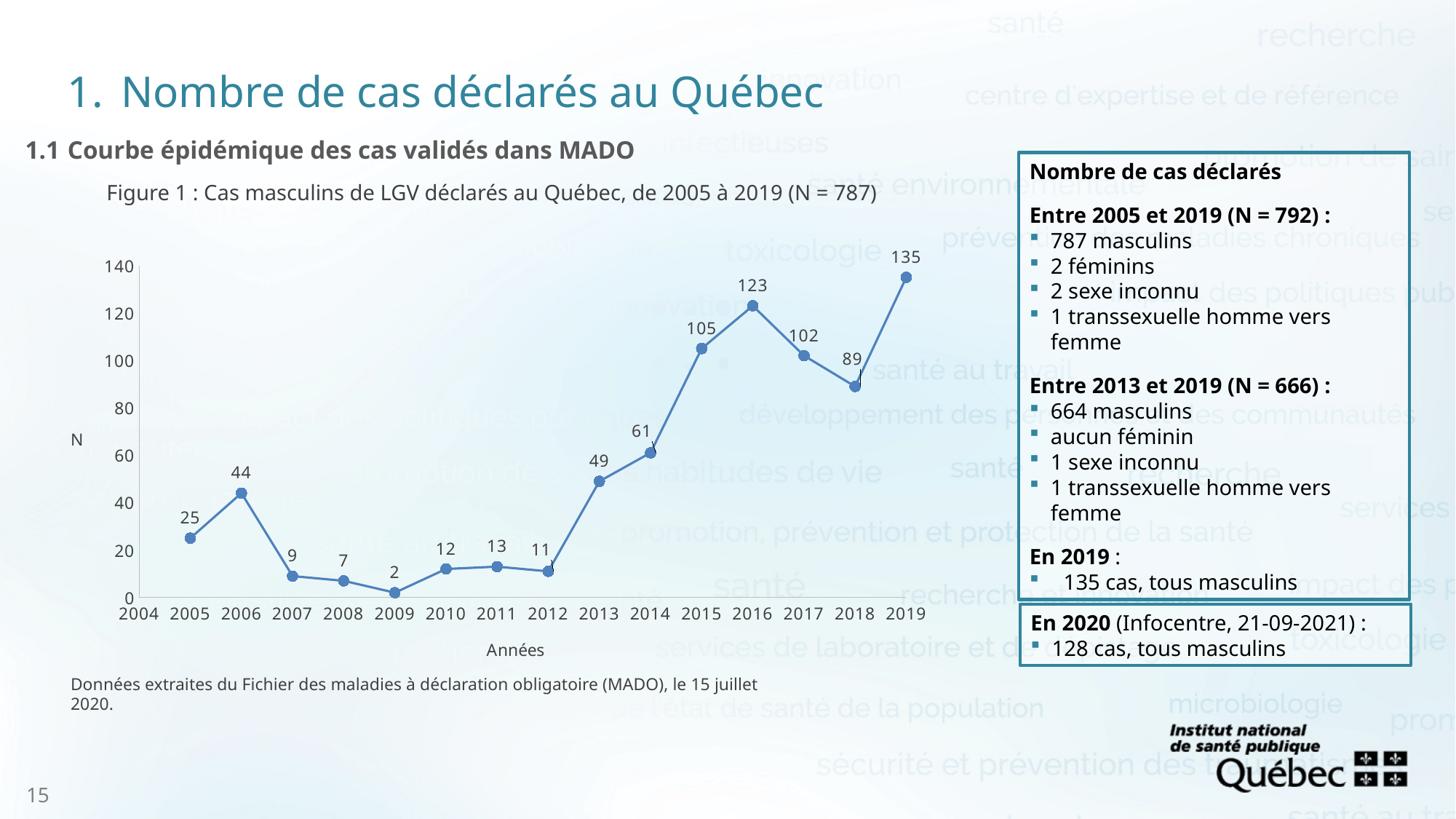
What is the title of Figure 1? Cas masculins de LGV déclarés au Québec, de 2005 à 2019 (N = 787) Between 2012 and 2016, do the values generally rise or fall? Rise How many years (data points) are plotted on the line? 15 Which year has the lowest number of declared male LGV cases? 2009 Is the value for 2014 greater or less than 80? less What is the label of the x axis? Années What is the difference between the number of cases in 2019 and in 2018? 46 Which year had more cases, 2015 or 2017? 2015 What is the value plotted for 2009? 2 How many male LGV cases were declared in Quebec in 2016? 123 Which year has the highest number of declared male LGV cases? 2019 What type of chart is shown in Figure 1? Line chart